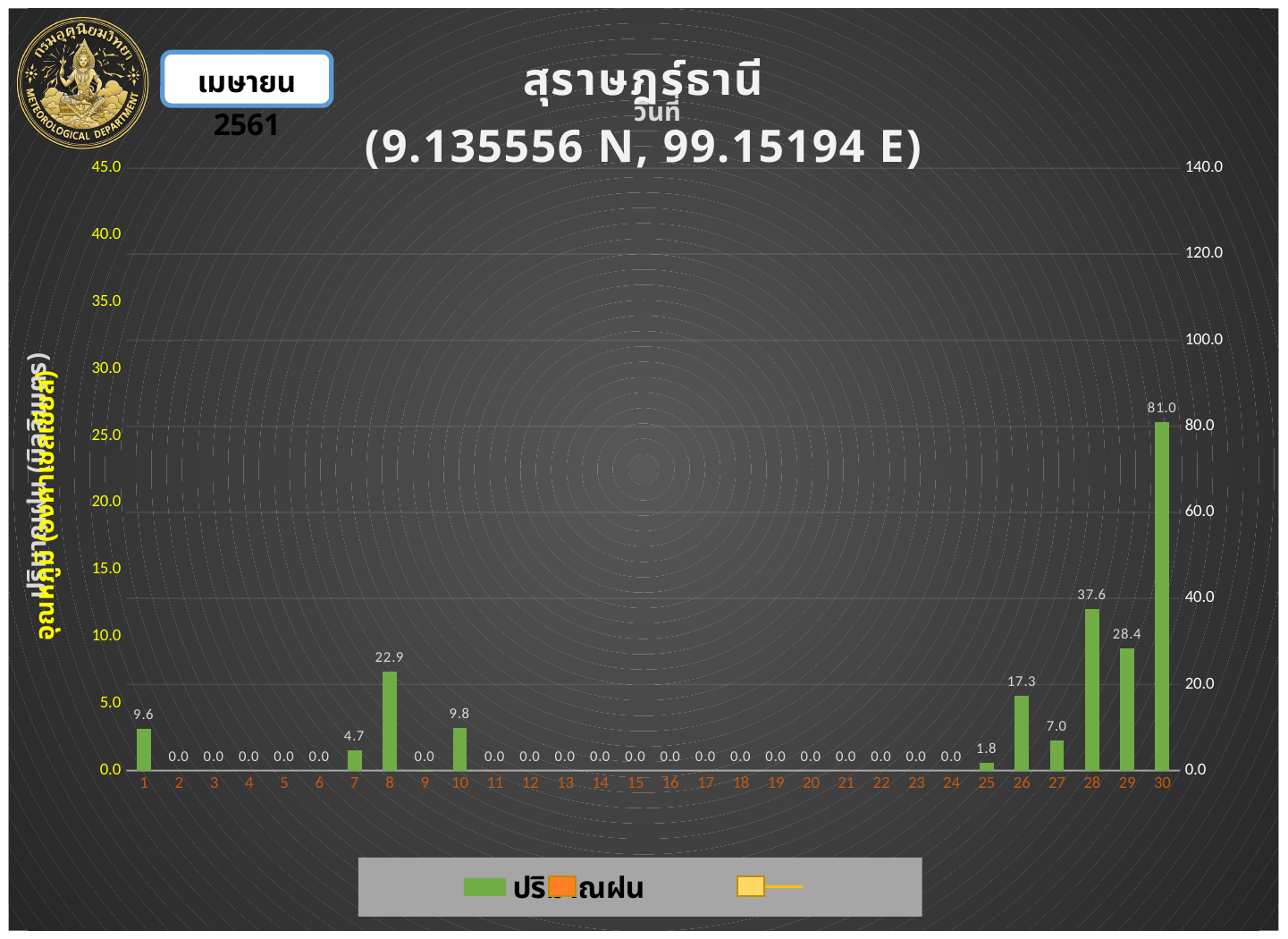
What is the rainfall value for day 8? 22.9 Which is larger, the rainfall value for day 29 or for day 8? day 29 Which day has the highest rainfall value? 30 What is the difference between the rainfall values for day 30 and day 28? 43.4 What is the difference between the rainfall values for day 26 and day 27? 10.3 Is the rainfall value for day 30 greater or less than 60.0 on the right axis? greater How many series does the legend list? 3 What is the rainfall value for day 1? 9.6 How many days (categories) are shown on the x axis? 30 What is the rainfall value (ปริมาณฝน) for day 30? 81.0 What kind of chart is used to show the rainfall values? bar chart What is the rainfall value for day 28? 37.6